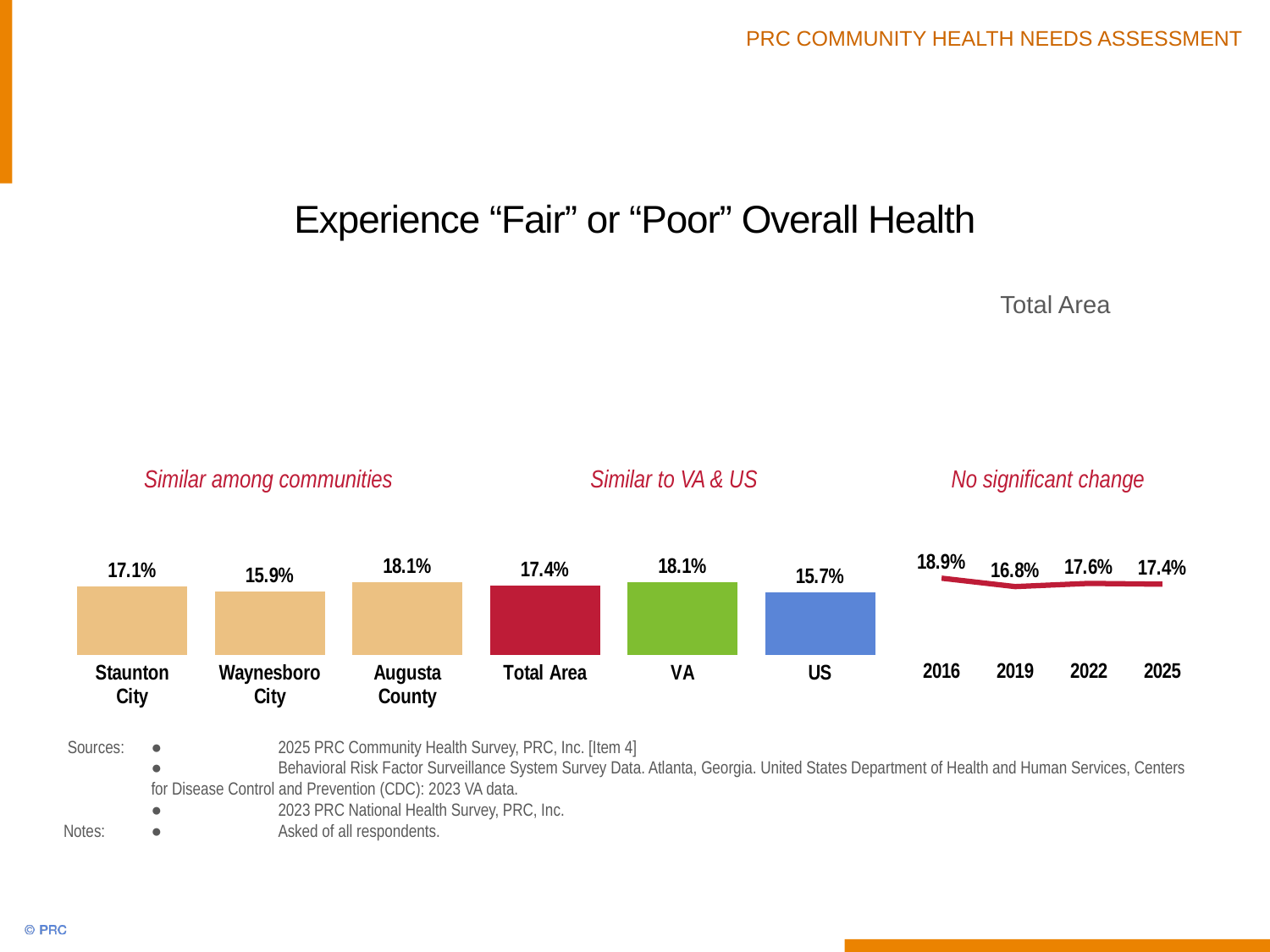
In the line chart on the right, what is the value for 2016? 18.9% What is the title of the slide's chart? Experience "Fair" or "Poor" Overall Health In the bar chart on the left, what is the value for Waynesboro City? 15.9% In the bar chart on the left, which is larger, the value for VA or the value for US? VA In the bar chart on the left, what is the difference between the values for Augusta County and Waynesboro City? 2.2% In the bar chart on the left, what is the value for Staunton City? 17.1% In the bar chart on the left, what is the value for the Total Area? 17.4% How many categories are shown in the bar chart on the left? 6 In the line chart on the right, what is the difference between the 2016 and 2025 values? 1.5% In the bar chart on the left, which category has the lowest value? US In the line chart on the right, which year has the lowest value? 2019 What kind of chart is the chart on the left of the slide? bar chart